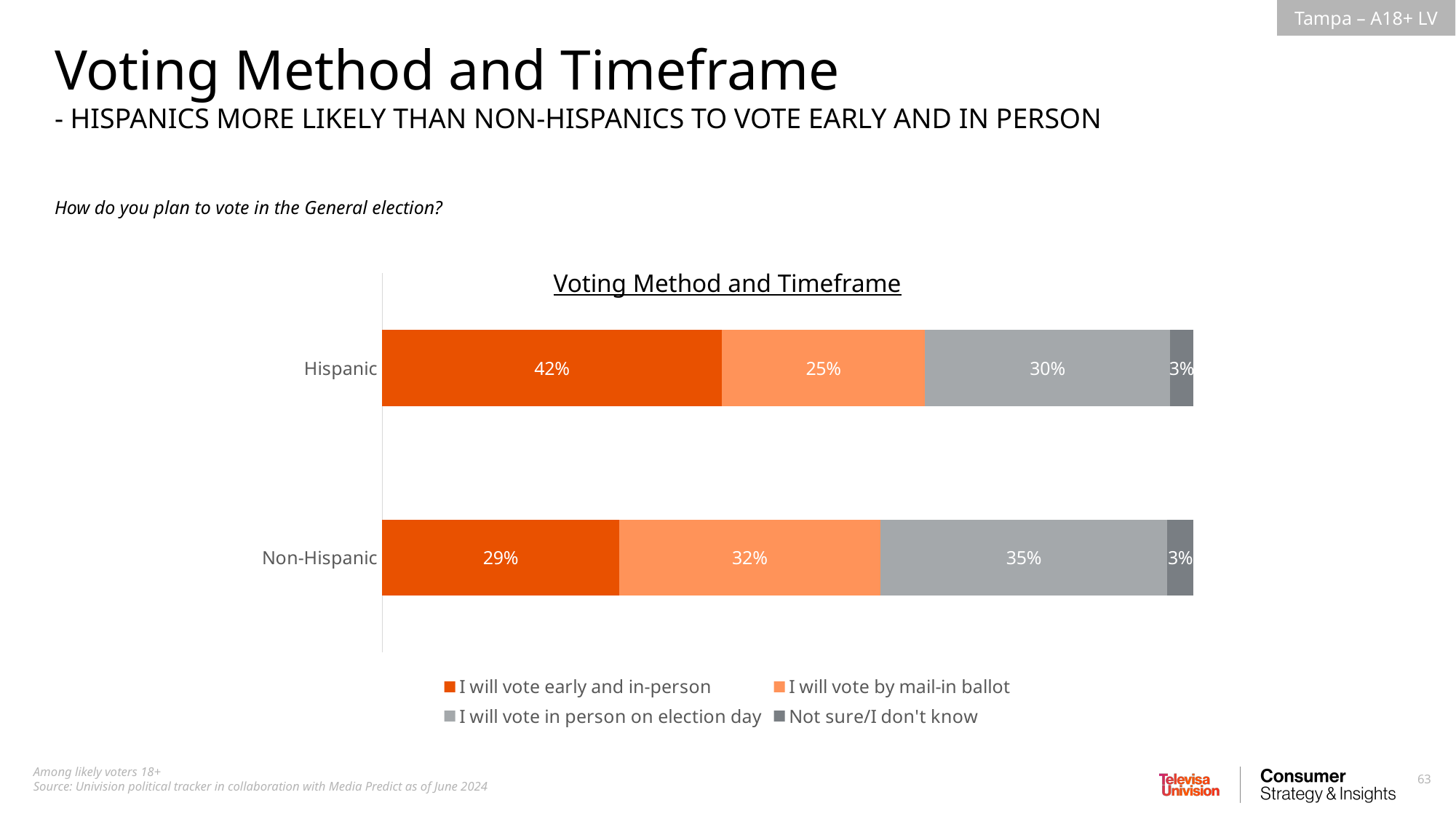
What is the difference in percentage points between Hispanic and Non-Hispanic respondents who will vote early and in-person? 13 percentage points Which voting method has the largest share among Non-Hispanic respondents? I will vote in person on election day How many series does the legend list? 4 Which group has the higher share saying they will vote early and in-person, Hispanic or Non-Hispanic? Hispanic What is the difference in percentage points between Non-Hispanic and Hispanic respondents who will vote in person on election day? 5 percentage points What percentage of Non-Hispanic respondents say they will vote by mail-in ballot? 32% What kind of chart is shown on the slide? Stacked bar chart What percentage of Hispanic respondents say they will vote early and in-person? 42% Which voting method has the largest share among Hispanic respondents? I will vote early and in-person What percentage of Hispanic respondents are not sure or don't know how they will vote? 3% What percentage of Non-Hispanic respondents say they will vote in person on election day? 35% Which group has the higher share saying they will vote by mail-in ballot, Hispanic or Non-Hispanic? Non-Hispanic